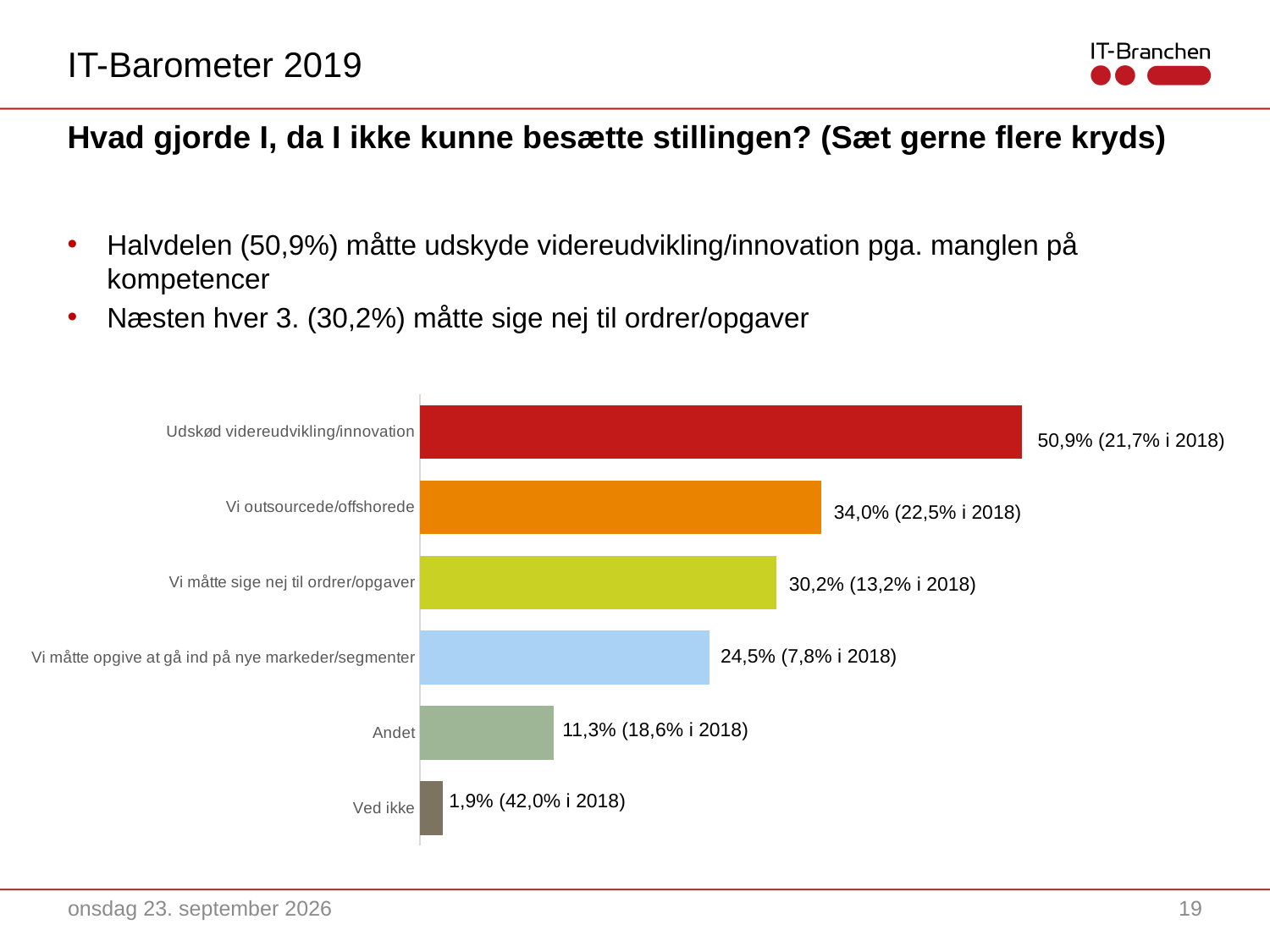
By how many percentage points did "Udskød videreudvikling/innovation" change from 2018 (21,7%) to 2019 (50,9%)? 29,2 percentage points What is the value shown for "Udskød videreudvikling/innovation" in the bar chart? 50,9% How many categories are shown in the bar chart? 6 Do the bar values increase or decrease going from the top category to the bottom category? Decrease Which is larger: the value for "Vi måtte opgive at gå ind på nye markeder/segmenter" or the value for "Andet"? Vi måtte opgive at gå ind på nye markeder/segmenter What is the difference in percentage points between "Udskød videreudvikling/innovation" (50,9%) and "Vi outsourcede/offshorede" (34,0%)? 16,9 percentage points What is the value shown for "Ved ikke"? 1,9% Which category has the lowest value in the bar chart? Ved ikke What was the 2018 value for "Vi måtte sige nej til ordrer/opgaver" according to the data label? 13,2% Which category has the highest value in the bar chart? Udskød videreudvikling/innovation What kind of chart is shown on the slide? Bar chart What is the value shown for "Vi outsourcede/offshorede"? 34,0%